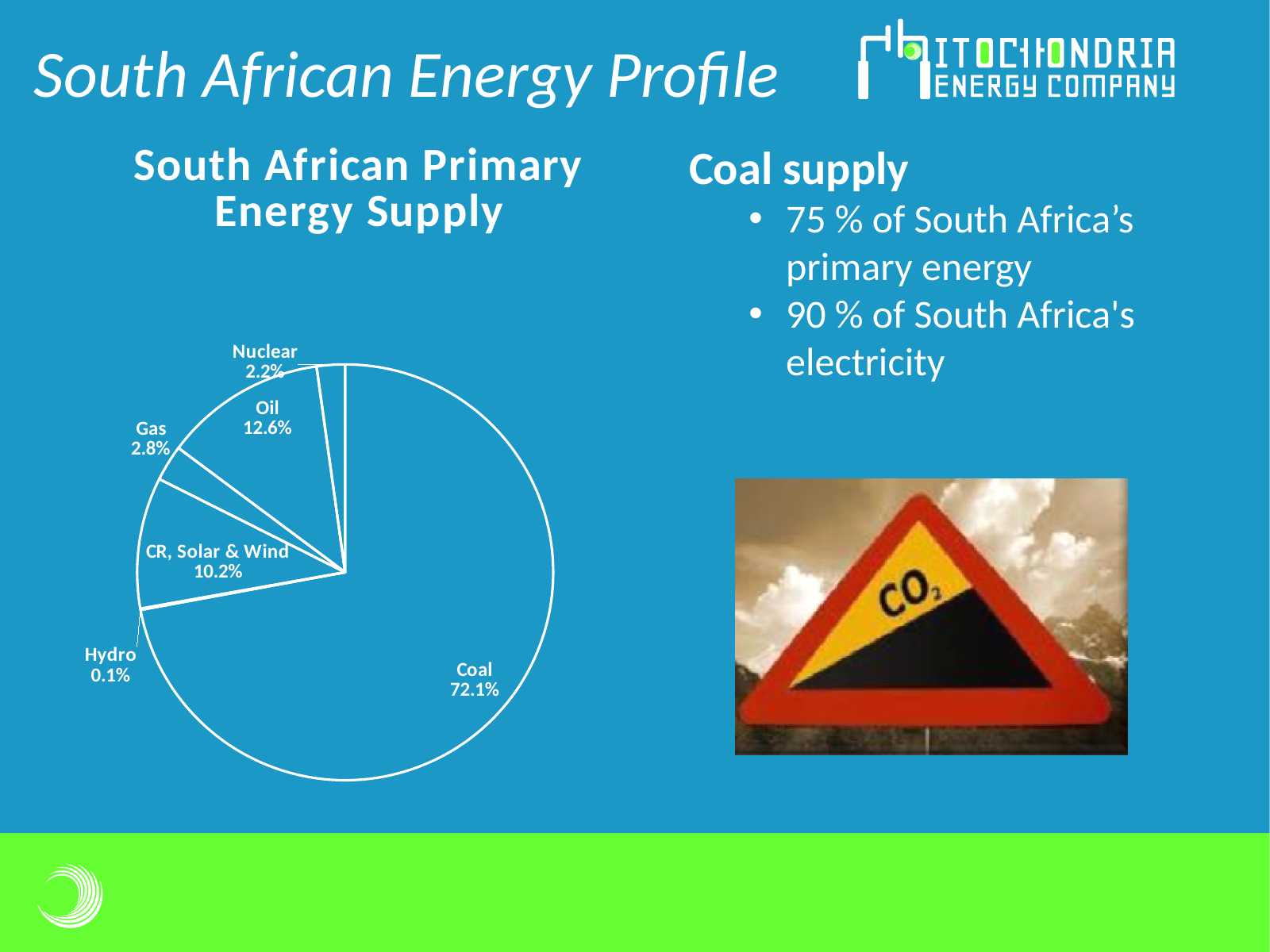
What percentage is shown for Hydro? 0.1% Which energy source has the largest share of the pie? Coal How many slices does the pie chart have? 6 Which energy source has the smallest share of the pie? Hydro What share of the pie is labelled Oil? 12.6% What type of chart is shown on the slide? Pie chart What is the difference in percentage points between the Coal and Oil shares? 59.5 What percentage is shown for Gas? 2.8% What percentage is shown for CR, Solar & Wind? 10.2% Which has a larger share, Oil or CR, Solar & Wind? Oil What share of South African primary energy supply comes from Coal? 72.1% What percentage is shown for Nuclear? 2.2%